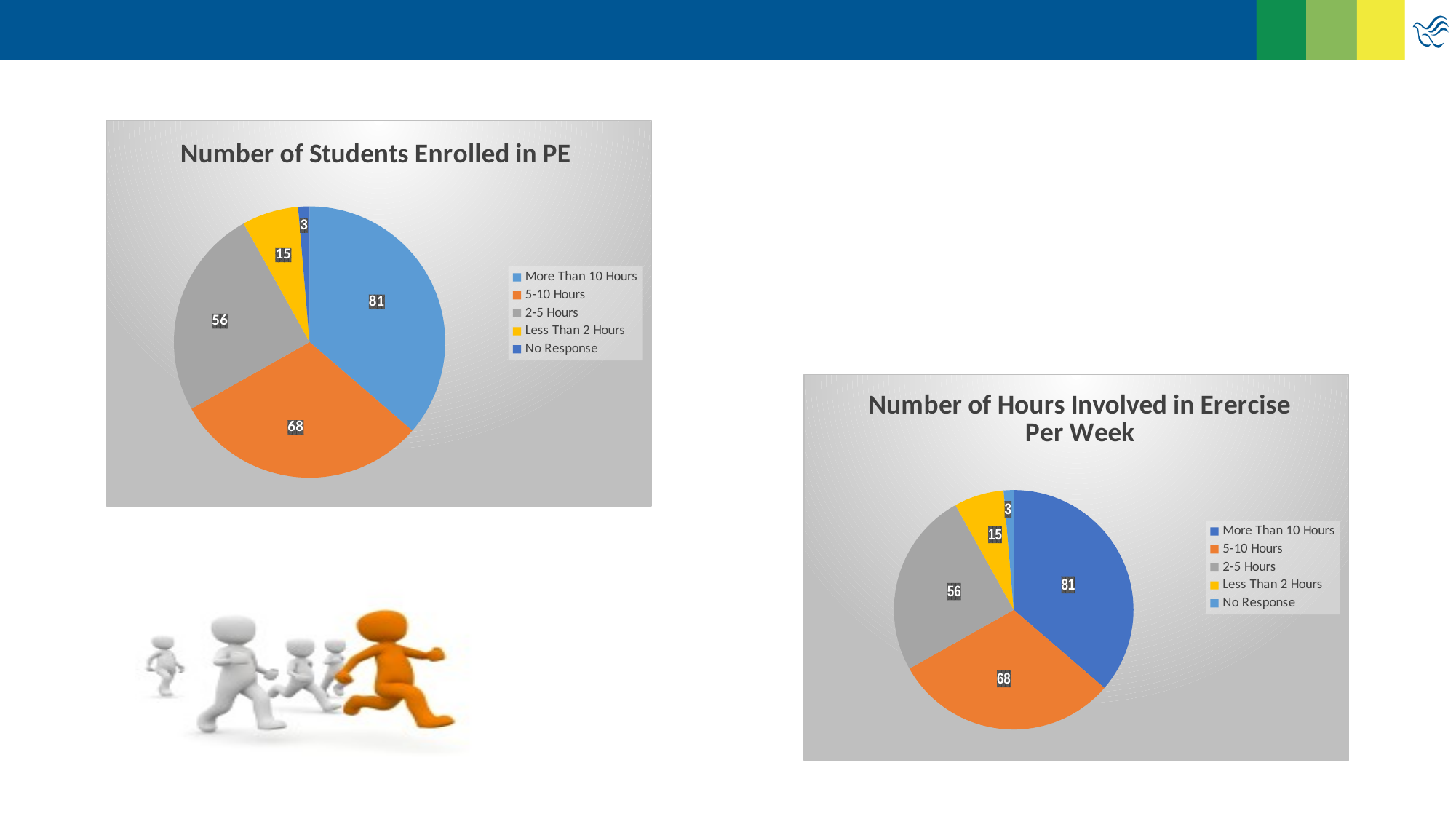
In the 'Number of Hours Involved in Erercise Per Week' chart, what is the total of all the slice values? 223 In the 'Number of Students Enrolled in PE' chart, what is the difference between the More Than 10 Hours and 5-10 Hours values? 13 What kind of chart is the 'Number of Hours Involved in Erercise Per Week' chart? Pie chart In the 'Number of Students Enrolled in PE' chart, what is the value for 5-10 Hours? 68 In the 'Number of Hours Involved in Erercise Per Week' chart, which is larger: 2-5 Hours or Less Than 2 Hours? 2-5 Hours In the 'Number of Hours Involved in Erercise Per Week' chart, which category has the smallest slice? No Response In the 'Number of Students Enrolled in PE' chart, which category has the largest slice? More Than 10 Hours In the 'Number of Hours Involved in Erercise Per Week' chart, what is the value for 2-5 Hours? 56 In the 'Number of Students Enrolled in PE' chart, what colour is the 5-10 Hours slice? Orange In the 'Number of Students Enrolled in PE' chart, what is the value for Less Than 2 Hours? 15 How many categories does the 'Number of Students Enrolled in PE' chart show? 5 In the 'Number of Hours Involved in Erercise Per Week' chart, what is the value for No Response? 3